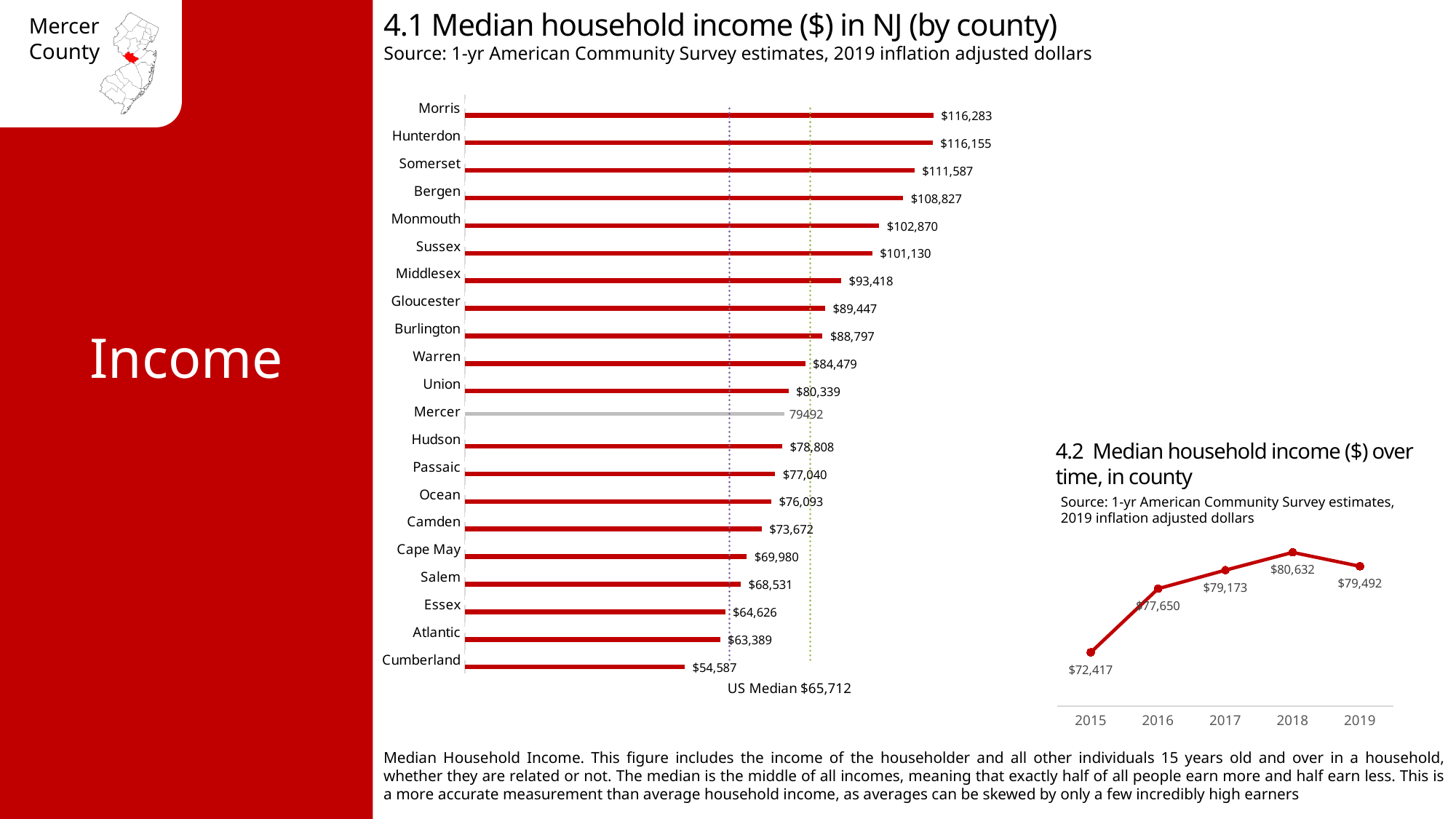
In chart 4.1 (Median household income by county), what is the median household income for Bergen? $108,827 In chart 4.2 (Median household income over time), what is the difference between the 2019 and 2015 values? $7,075 In chart 4.1 (Median household income by county), how many counties are shown? 21 What kind of chart is chart 4.1 (Median household income by county)? Bar chart In chart 4.1 (Median household income by county), which county has the lowest median household income? Cumberland In chart 4.1 (Median household income by county), which is larger, Hudson or Passaic? Hudson In chart 4.1 (Median household income by county), what is the median household income for Mercer? 79492 In chart 4.2 (Median household income over time), which year had the highest median household income? 2018 In chart 4.2 (Median household income over time), what was the median household income in 2016? $77,650 In chart 4.1 (Median household income by county), what is the difference between Bergen and Monmouth? $5,957 In chart 4.1 (Median household income by county), which county has the highest median household income? Morris In chart 4.2 (Median household income over time), how many years are plotted? 5